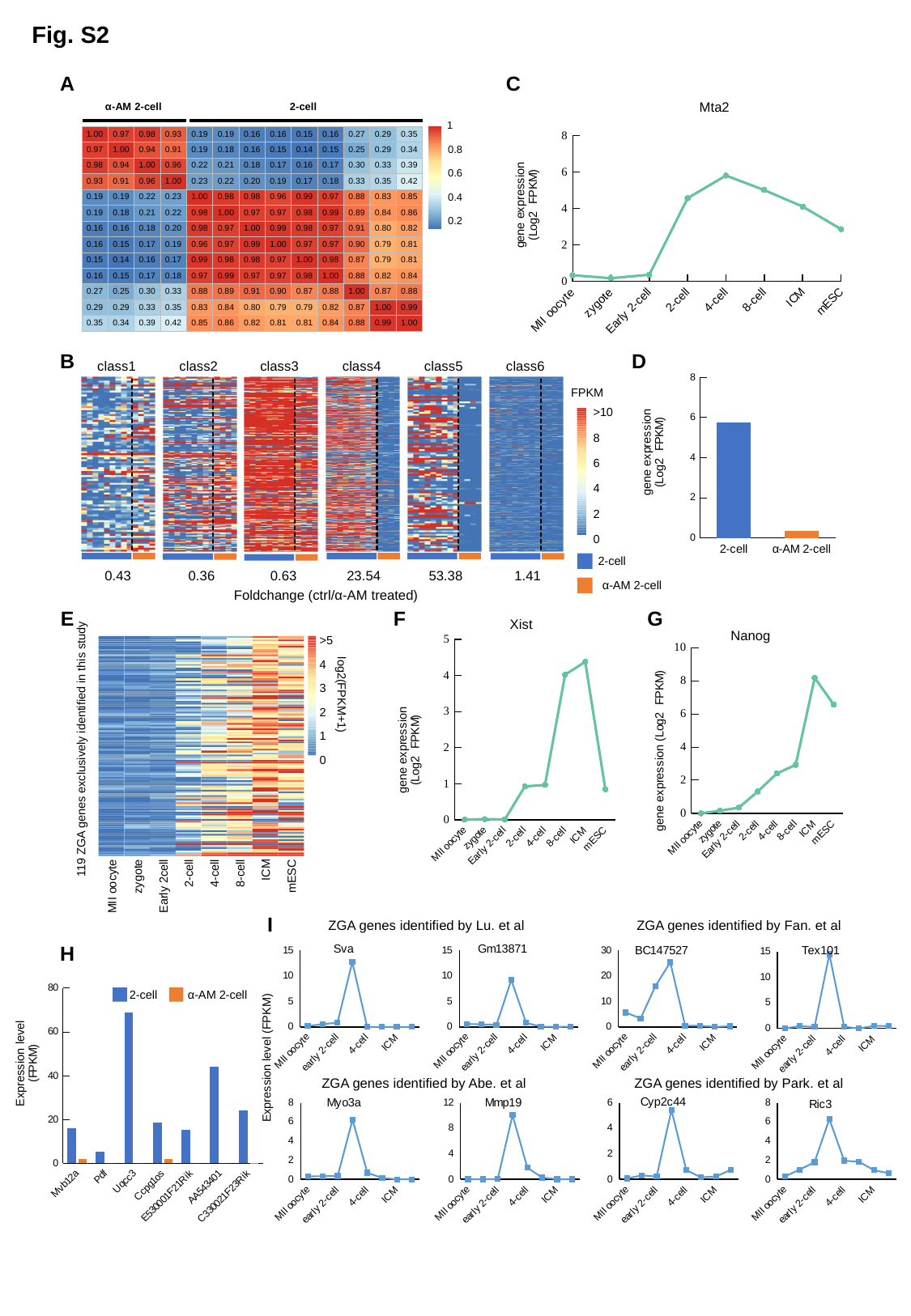
In panel B, which class has the highest printed fold change? class5 In panel B, what is the fold change printed for class1? 0.43 In panel B, which class has the lowest printed fold change? class2 In panel H, how many series does the legend list? 2 In panel G (Nanog), at which stage is gene expression highest? ICM In panel C (Mta2), how many stages are plotted along the x axis? 8 In panel D, is the gene expression value for 2-cell greater or less than 4? greater In panel B, what is the difference between the fold change of class5 and class4? 29.84 In panel C (Mta2), at which stage does gene expression reach its highest value? 4-cell In panel D, which bar is taller, 2-cell or α-AM 2-cell? 2-cell In panel B, what is the fold change (ctrl/α-AM treated) printed for class5? 53.38